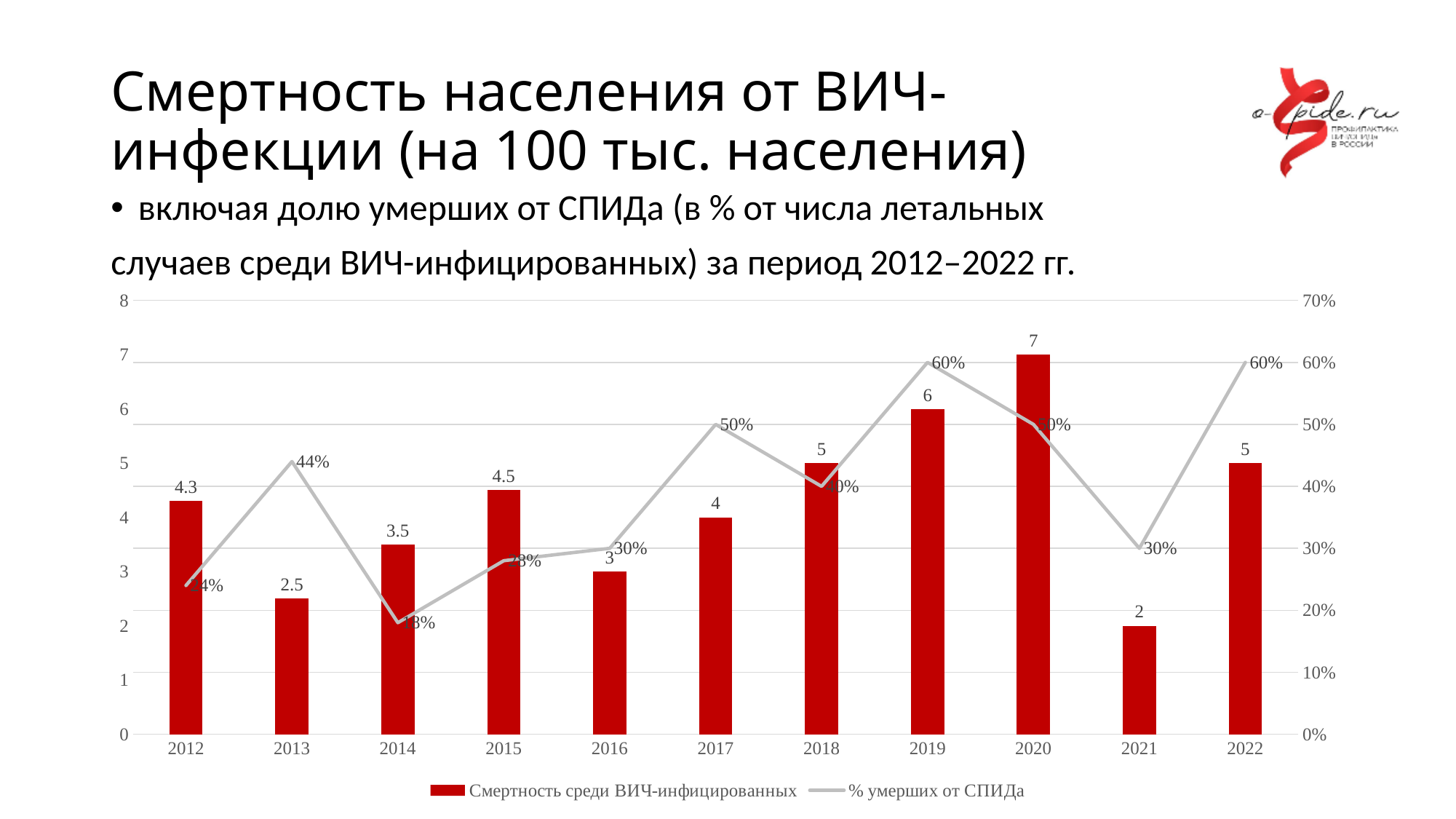
What kind of chart is shown on the slide? Combined bar and line chart Which year has the lowest bar for "Смертность среди ВИЧ-инфицированных"? 2021 What is the difference between the bar values for 2020 and 2021? 5 Which is larger, the bar value for 2015 or the bar value for 2016? 2015 How many series does the legend list? 2 How many years are shown on the x axis? 11 Is the line value for 2020 greater or less than 40%? greater What is the value of the bar for 2020? 7 What is the value of the line series "% умерших от СПИДа" for 2013? 44% What is the value of the bar for 2012? 4.3 Which year has the highest bar for "Смертность среди ВИЧ-инфицированных"? 2020 What is the value of the line series "% умерших от СПИДа" for 2019? 60%